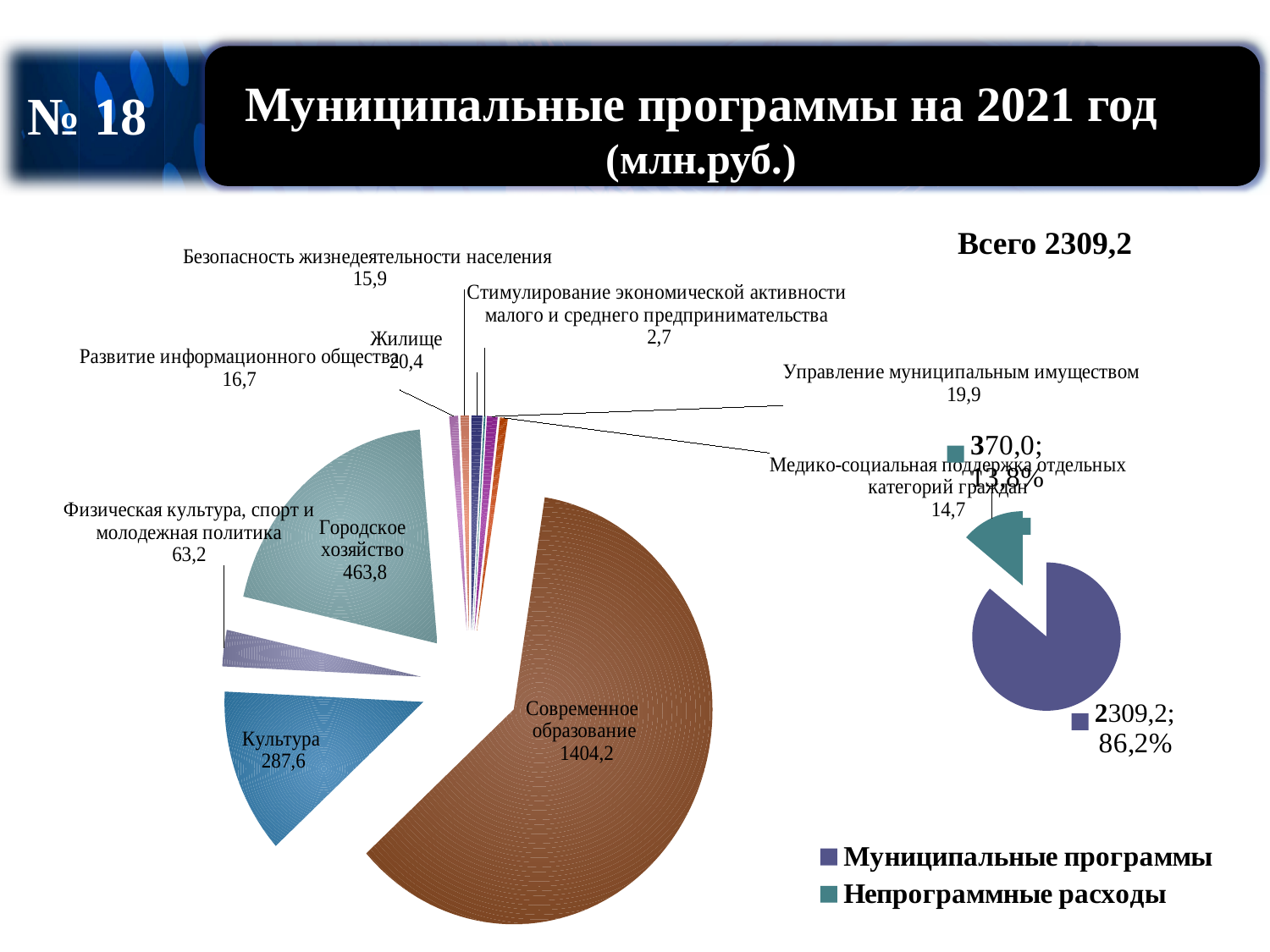
In the large pie chart on the left, what is the value for Городское хозяйство? 463,8 In the large pie chart on the left, what is the value for Культура? 287,6 In the large pie chart on the left, what is the value for Современное образование? 1404,2 In the large pie chart on the left, which category has the largest value? Современное образование In the large pie chart on the left, what is the value for Жилище? 20,4 In the small pie chart on the right, what is the value for Непрограммные расходы? 370,0 In the small pie chart on the right, what share do Муниципальные программы make up? 86,2% In the large pie chart on the left, which is larger: Культура or Физическая культура, спорт и молодежная политика? Культура What kind of chart is the small chart on the right? pie chart In the large pie chart on the left, which category has the smallest value? Стимулирование экономической активности малого и среднего предпринимательства In the large pie chart on the left, what is the difference between Современное образование and Городское хозяйство? 940,4 How many categories does the large pie chart on the left show? 10